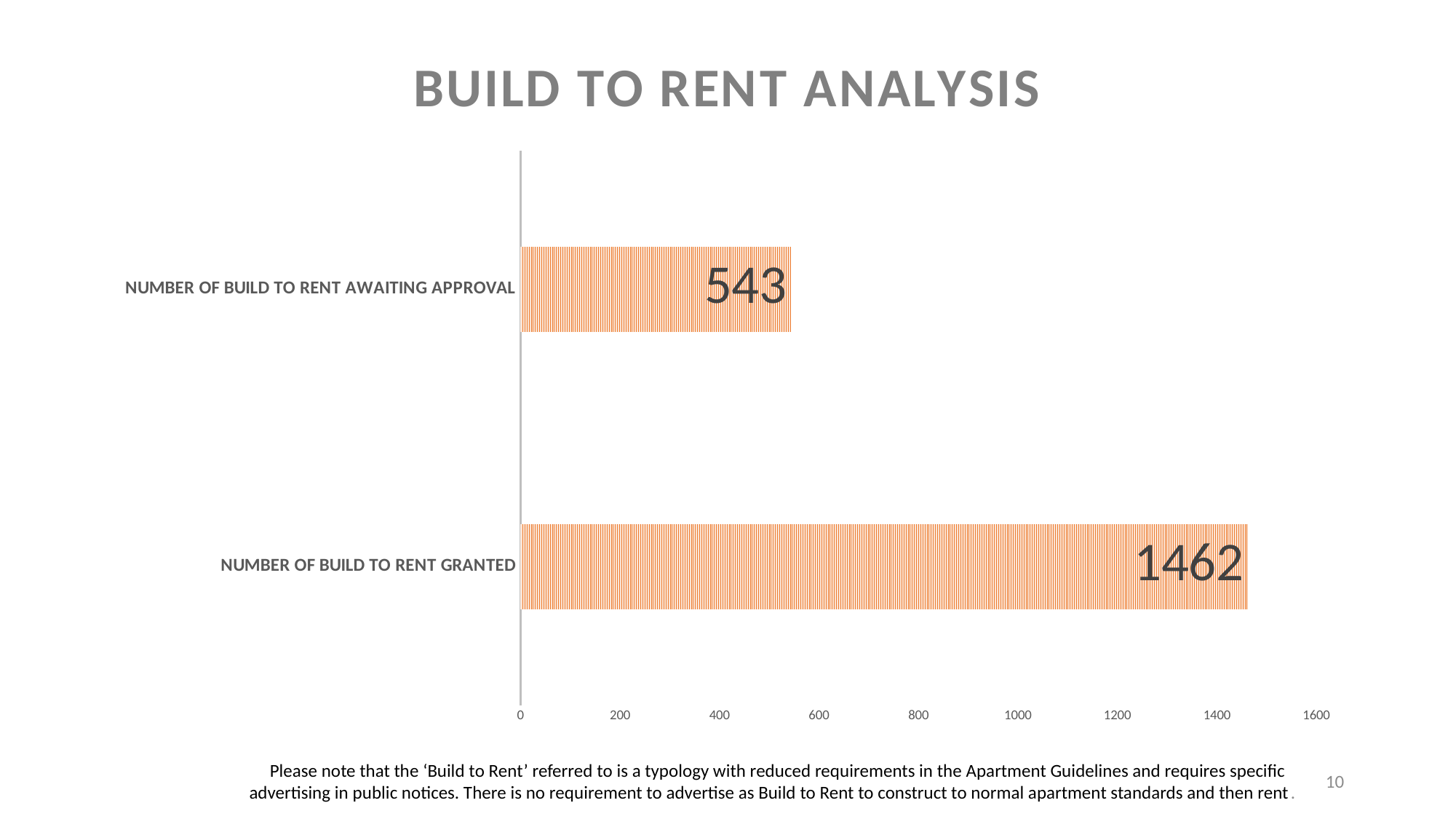
Which is larger: Number of Build to Rent Granted or Number of Build to Rent Awaiting Approval? Number of Build to Rent Granted Is the value for Number of Build to Rent Granted greater or less than 1400? greater What kind of chart is shown on the slide? Bar chart What is the maximum value shown on the horizontal axis? 1600 How many categories are shown in the chart? 2 Which category has the lowest value? Number of Build to Rent Awaiting Approval Is the value for Number of Build to Rent Awaiting Approval greater or less than 600? less What is the value for Number of Build to Rent Awaiting Approval? 543 What is the value for Number of Build to Rent Granted? 1462 What is the title of the slide? BUILD TO RENT ANALYSIS What is the difference between the number of Build to Rent Granted and the number Awaiting Approval? 919 Which category has the highest value? Number of Build to Rent Granted